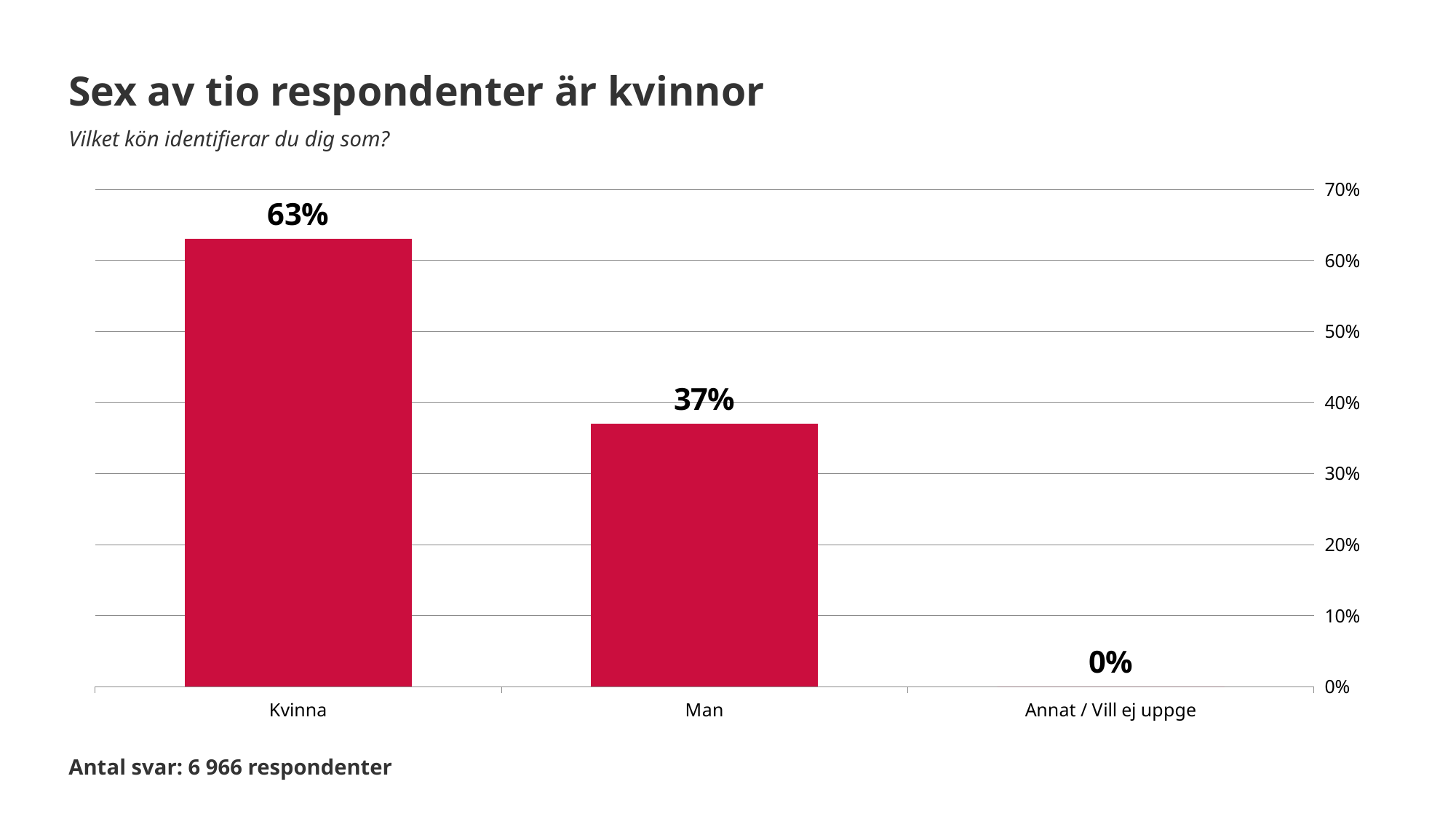
Which is larger, the value for Kvinna or the value for Man? Kvinna Which category has the lowest value? Annat / Vill ej uppge What is the difference between the values for Kvinna and Man? 26% Is the value for Man greater or less than 40%? less What is the value for Kvinna? 63% What is the value for Man? 37% How many categories are shown on the x axis? 3 What is the title of the slide? Sex av tio respondenter är kvinnor What is the value for Annat / Vill ej uppge? 0% Is the value for Kvinna greater or less than 60%? greater What kind of chart is shown on the slide? bar chart Which category has the highest value? Kvinna